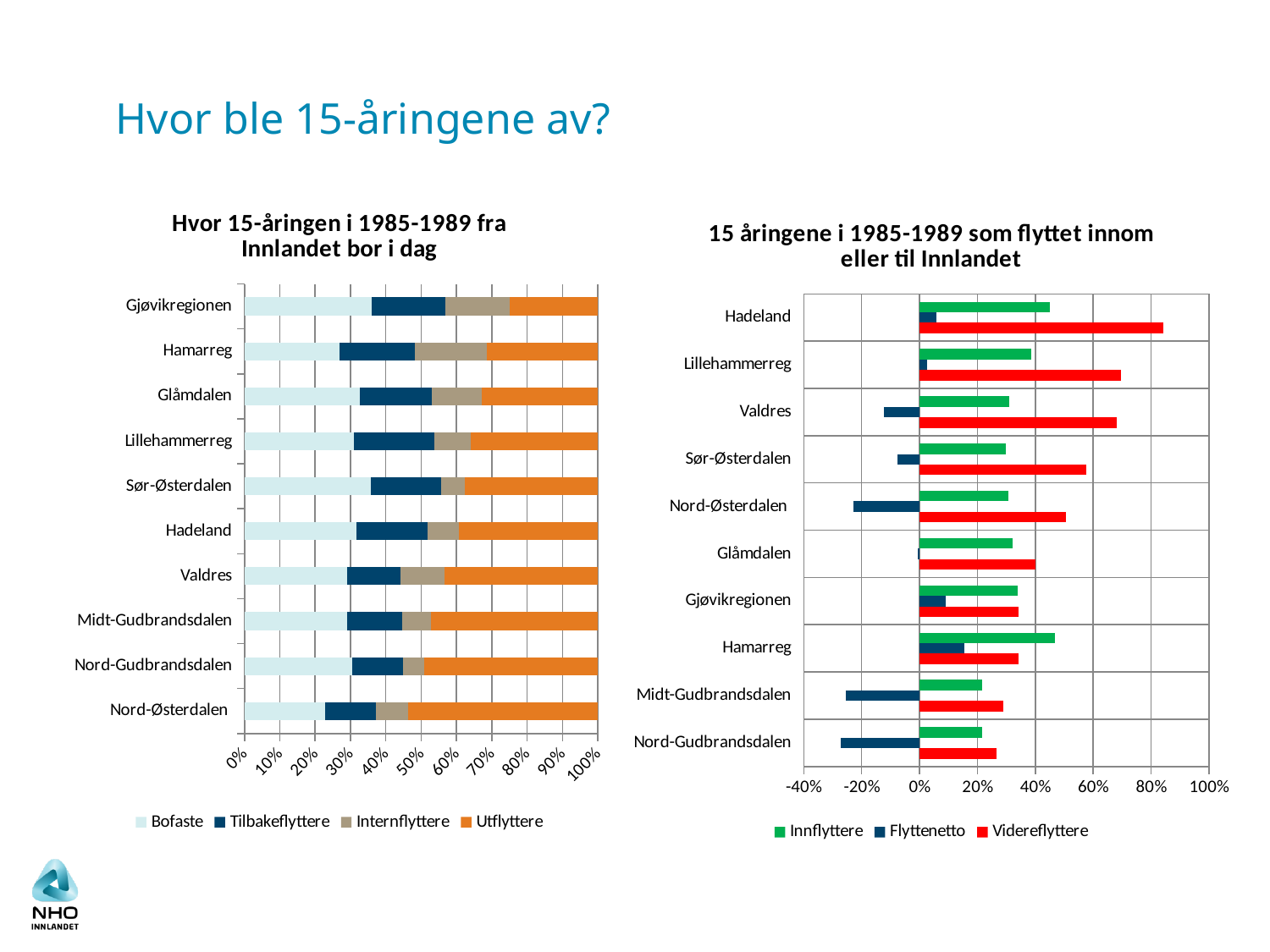
How many series does the legend of the right chart, '15 åringene i 1985-1989 som flyttet innom eller til Innlandet', list? 3 How many series does the legend of the left chart, 'Hvor 15-åringen i 1985-1989 fra Innlandet bor i dag', list? 4 In the right chart, '15 åringene i 1985-1989 som flyttet innom eller til Innlandet', which region has the highest Videreflyttere value? Hadeland In the right chart, '15 åringene i 1985-1989 som flyttet innom eller til Innlandet', which is larger: the Videreflyttere value for Hadeland or for Gjøvikregionen? Hadeland How many regions are shown on the right chart, '15 åringene i 1985-1989 som flyttet innom eller til Innlandet'? 10 How many regions are listed on the left chart, 'Hvor 15-åringen i 1985-1989 fra Innlandet bor i dag'? 10 In the right chart, '15 åringene i 1985-1989 som flyttet innom eller til Innlandet', is the Flyttenetto value for Nord-Gudbrandsdalen greater or less than -20%? less In the left chart, 'Hvor 15-åringen i 1985-1989 fra Innlandet bor i dag', is the Bofaste share for Hamarreg greater or less than 30%? less In the right chart, '15 åringene i 1985-1989 som flyttet innom eller til Innlandet', is the Videreflyttere value for Hadeland greater or less than 60%? greater What kind of chart is the left chart, 'Hvor 15-åringen i 1985-1989 fra Innlandet bor i dag'? Stacked bar chart